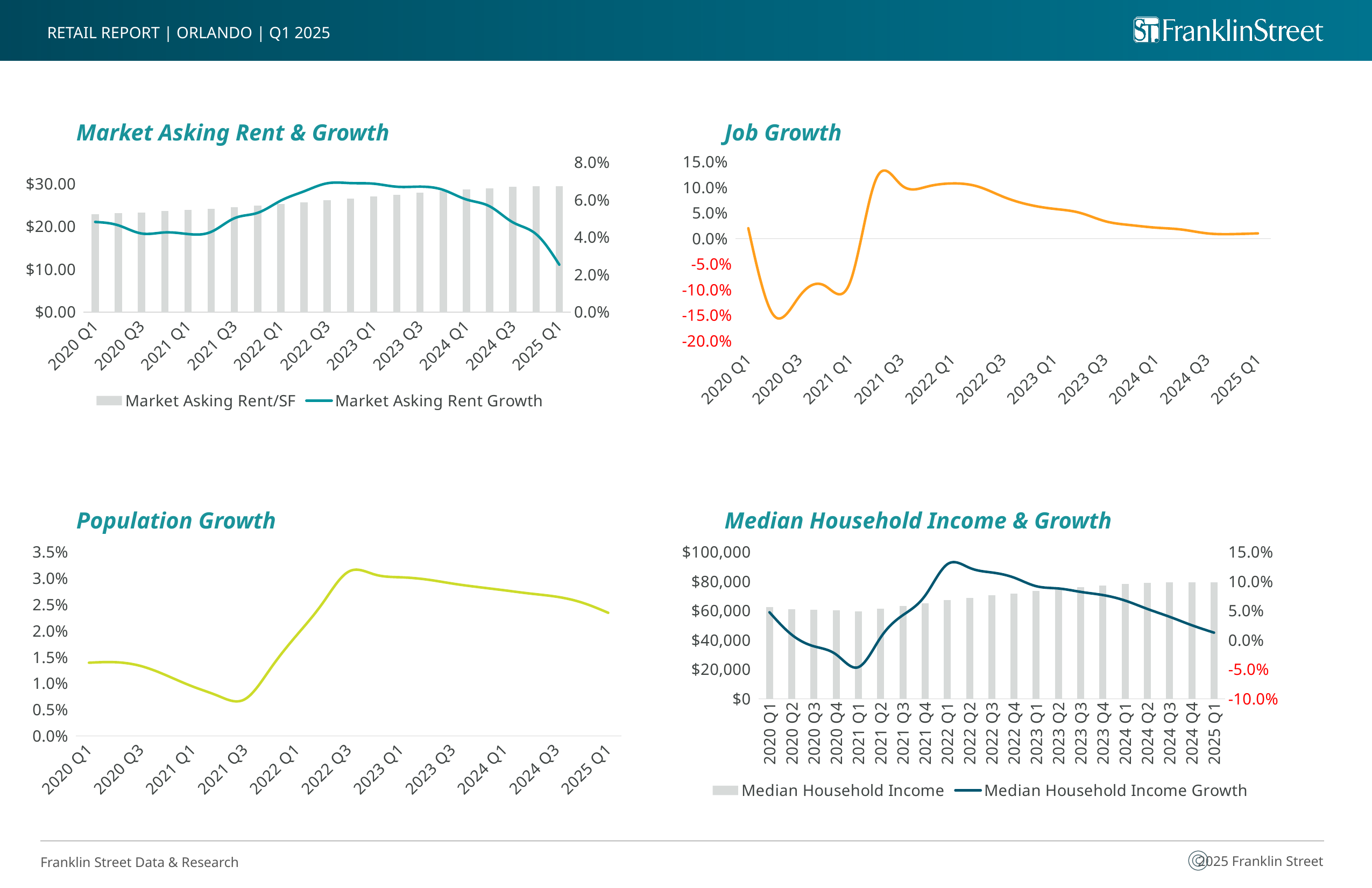
On the Market Asking Rent & Growth chart, how many series does the legend list? 2 On the Job Growth chart, is the value for 2020 Q3 greater or less than -10.0%? less On the Median Household Income & Growth chart, how many quarters are shown on the x axis? 21 On the Population Growth chart, is the value for 2021 Q3 greater or less than 1.0%? less On the Median Household Income & Growth chart, is the Median Household Income Growth for 2021 Q1 greater or less than 0.0%? less On the Market Asking Rent & Growth chart, do the Market Asking Rent/SF bars generally rise or fall from 2020 Q1 to 2025 Q1? rise On the Median Household Income & Growth chart, what are the two legend entries? Median Household Income; Median Household Income Growth What kind of chart is the Job Growth chart? line chart